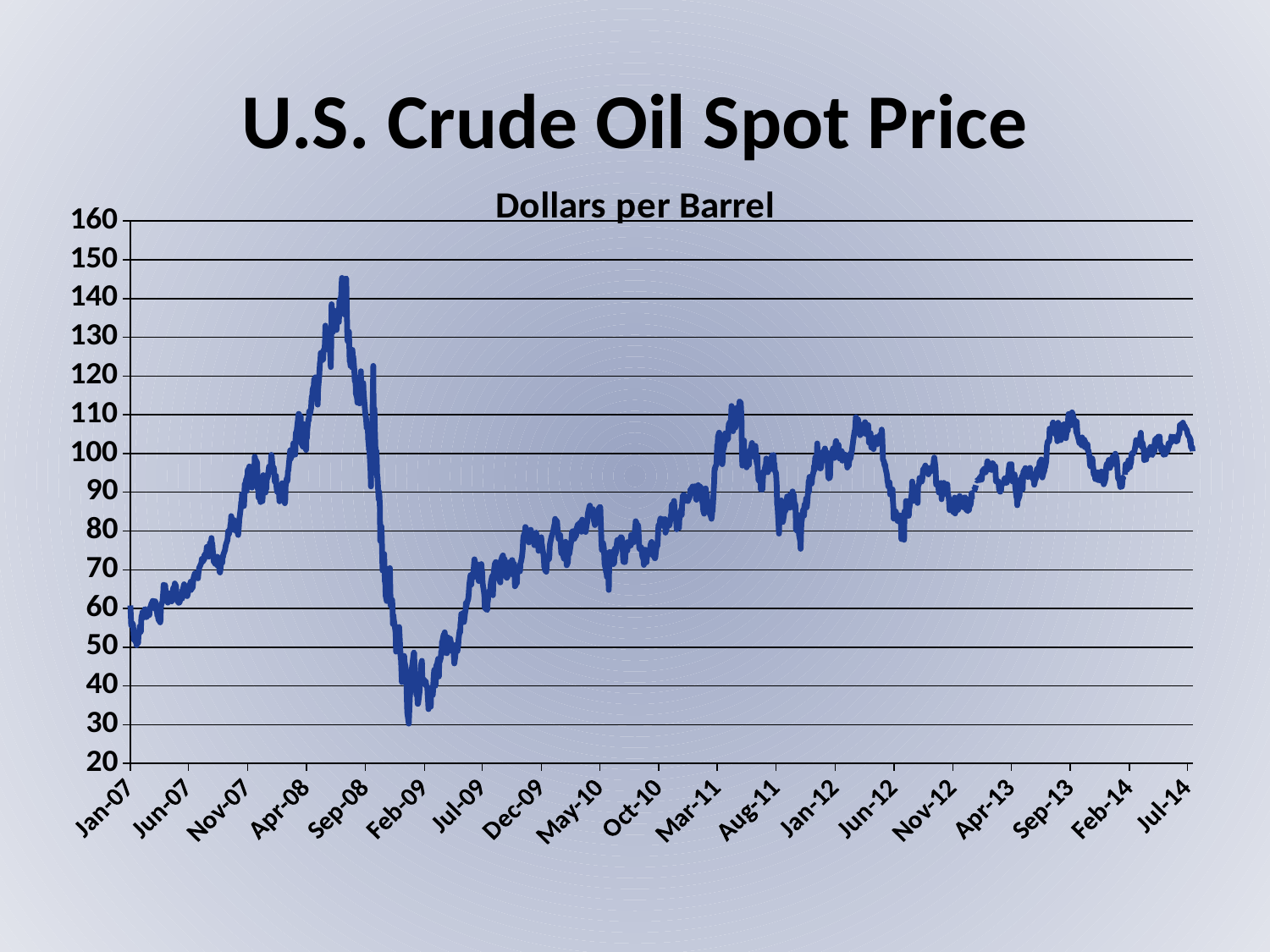
Is the crude oil spot price at Jan-07 greater or less than 70? less What unit is the price measured in, according to the chart subtitle? Dollars per Barrel How many date labels are shown on the x axis? 19 Is the peak value of the crude oil spot price in mid-2008 greater or less than 140? greater Which is larger: the crude oil spot price around Feb-09 or around Jul-14? Jul-14 Does the crude oil spot price rise or fall between Jan-07 and Sep-08? rise What kind of chart is shown on the slide? line chart Does the crude oil spot price rise or fall between Sep-08 and Feb-09? fall Is the crude oil spot price at Jul-14 greater or less than 90? greater Which is higher: the peak price in 2008 or the peak price in 2011? the peak price in 2008 What is the title of the chart? Dollars per Barrel